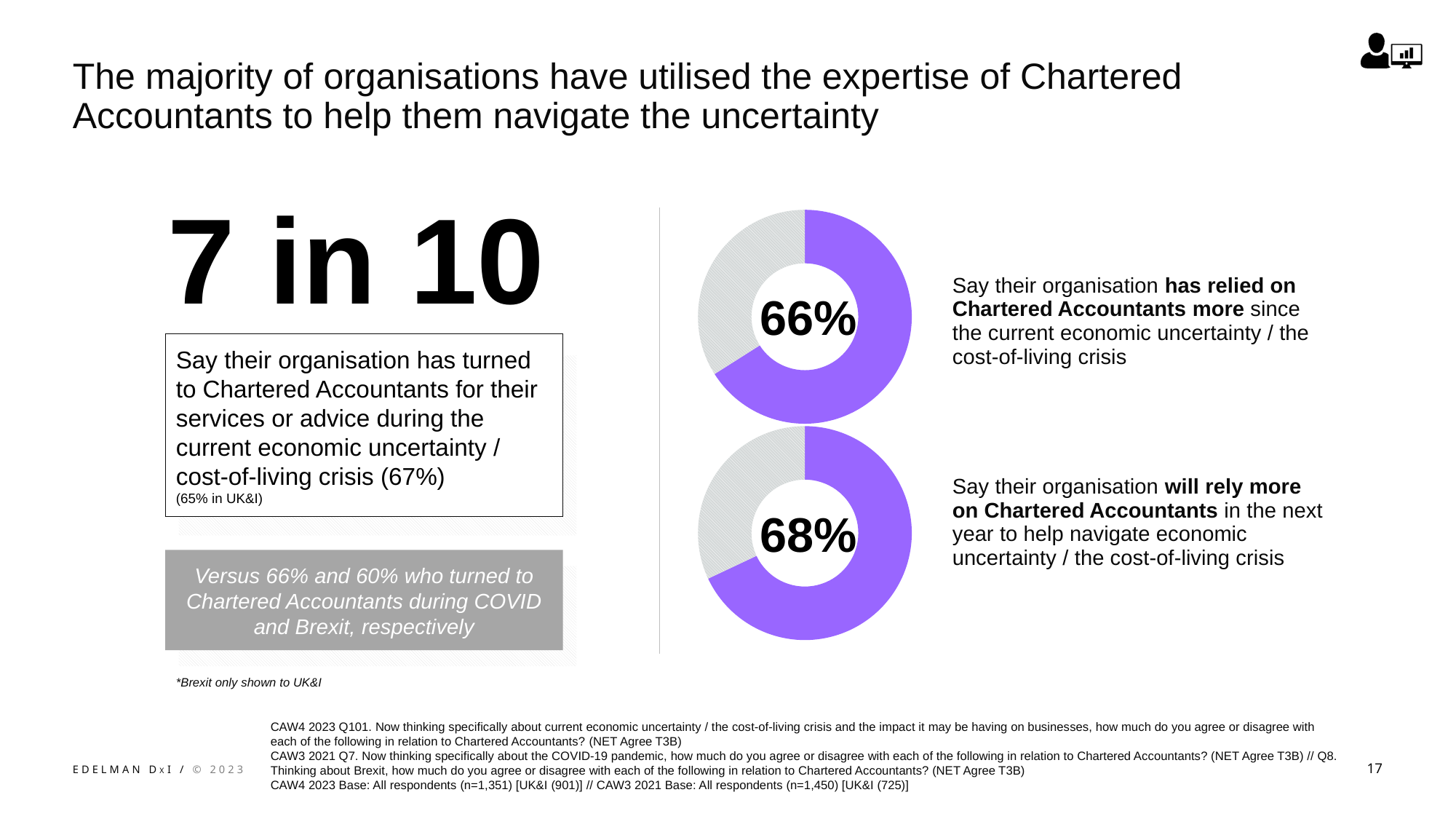
What percentage is shown in the centre of the bottom donut chart? 68% In the top donut chart, what share of the ring is not filled in purple? 34% What share of respondents say their organisation will rely more on Chartered Accountants in the next year? 68% What large headline statistic is shown on the left of the slide? 7 in 10 How many donut charts are on the slide? 2 What is the difference in percentage points between the bottom donut chart value (68%) and the top donut chart value (66%)? 2 percentage points What percentage is shown in the centre of the top donut chart? 66% Which is larger: the value in the top donut chart or the value in the bottom donut chart? The bottom donut chart (68%) What share of respondents say their organisation has relied on Chartered Accountants more since the current economic uncertainty / cost-of-living crisis? 66% Is the value in the top donut chart greater or less than 50%? greater What colour is used for the filled portion of the donut charts? Purple What kind of charts are shown on the right side of the slide? Donut (pie) charts